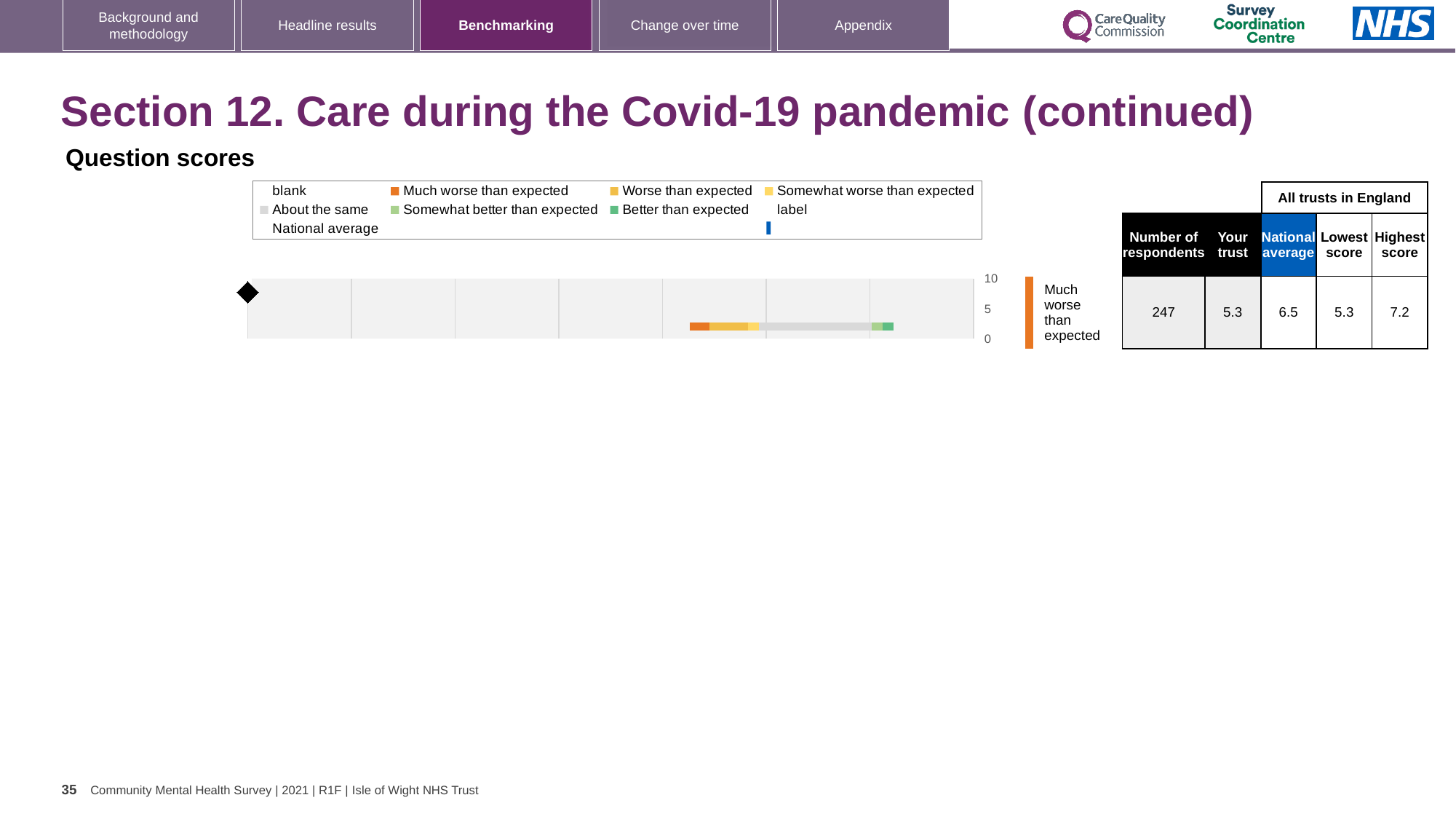
What is the score for Your trust shown in the table next to the chart? 5.3 What benchmark category label is shown beside the chart for this question? Much worse than expected What is the difference between the National average score and the Your trust score? 1.2 What is the maximum value shown on the chart's axis? 10 What is the Lowest score among all trusts in England shown in the table? 5.3 What colour does the legend use for 'Much worse than expected'? Orange What is the difference between the Highest score and the Lowest score among all trusts in England? 1.9 How many respondents are shown in the table next to the chart? 247 Which is larger, the Your trust score or the National average score? National average Is the Your trust score greater or less than 5 on the chart's axis? greater What is the Highest score among all trusts in England shown in the table? 7.2 What is the National average score shown in the table next to the chart? 6.5